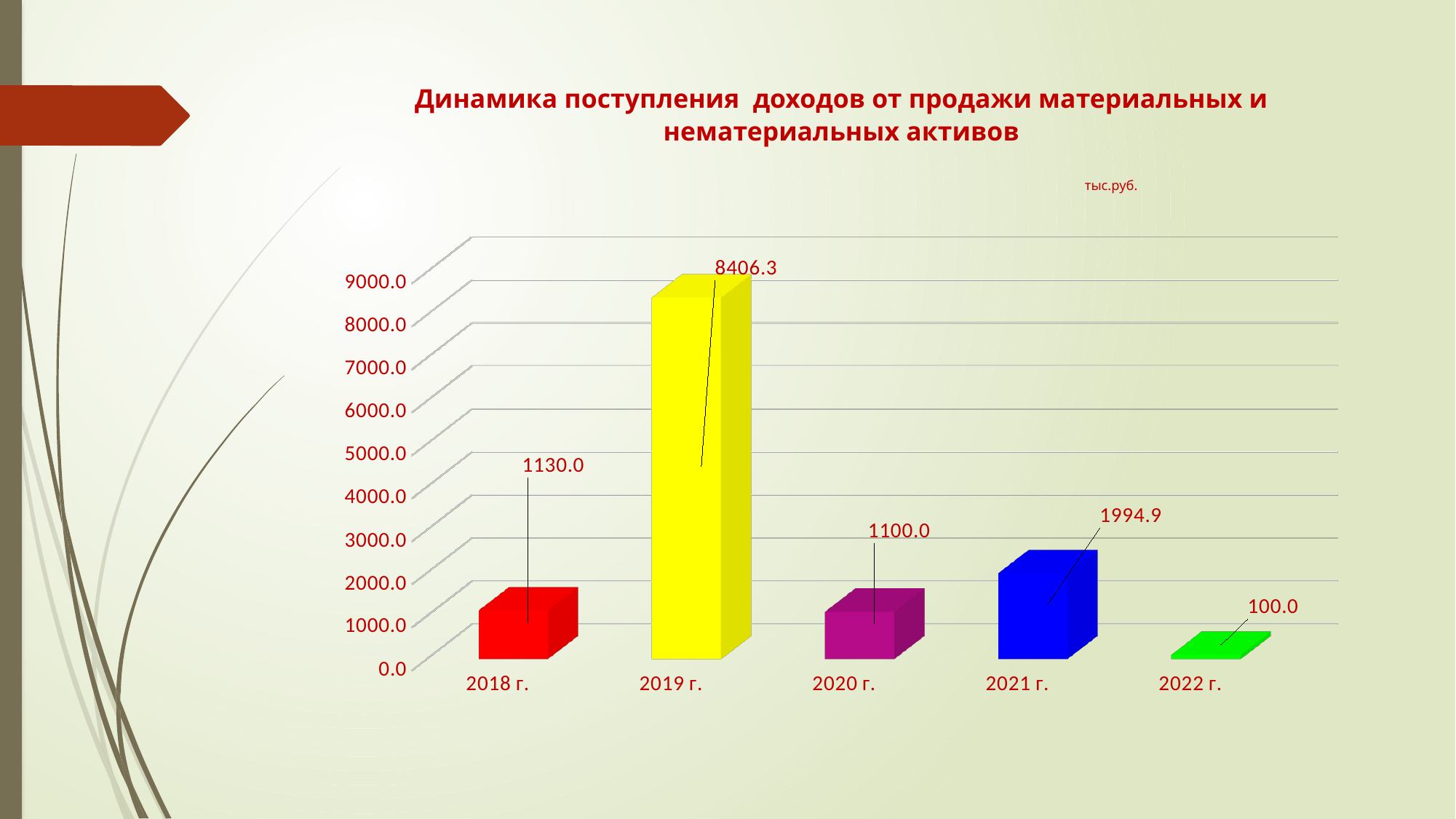
What unit is indicated above the chart? тыс.руб. What kind of chart is shown on the slide? bar chart Which year has the lowest value? 2022 г. What is the value for 2022 г.? 100.0 How many years are shown on the x axis? 5 What is the value for 2021 г.? 1994.9 What is the difference between the values for 2021 г. and 2020 г.? 894.9 What is the value for 2018 г.? 1130.0 What is the value for 2019 г.? 8406.3 Which year has the highest value? 2019 г. Is the value for 2019 г. greater or less than 8000.0? greater Which is larger, the value for 2018 г. or the value for 2020 г.? 2018 г.